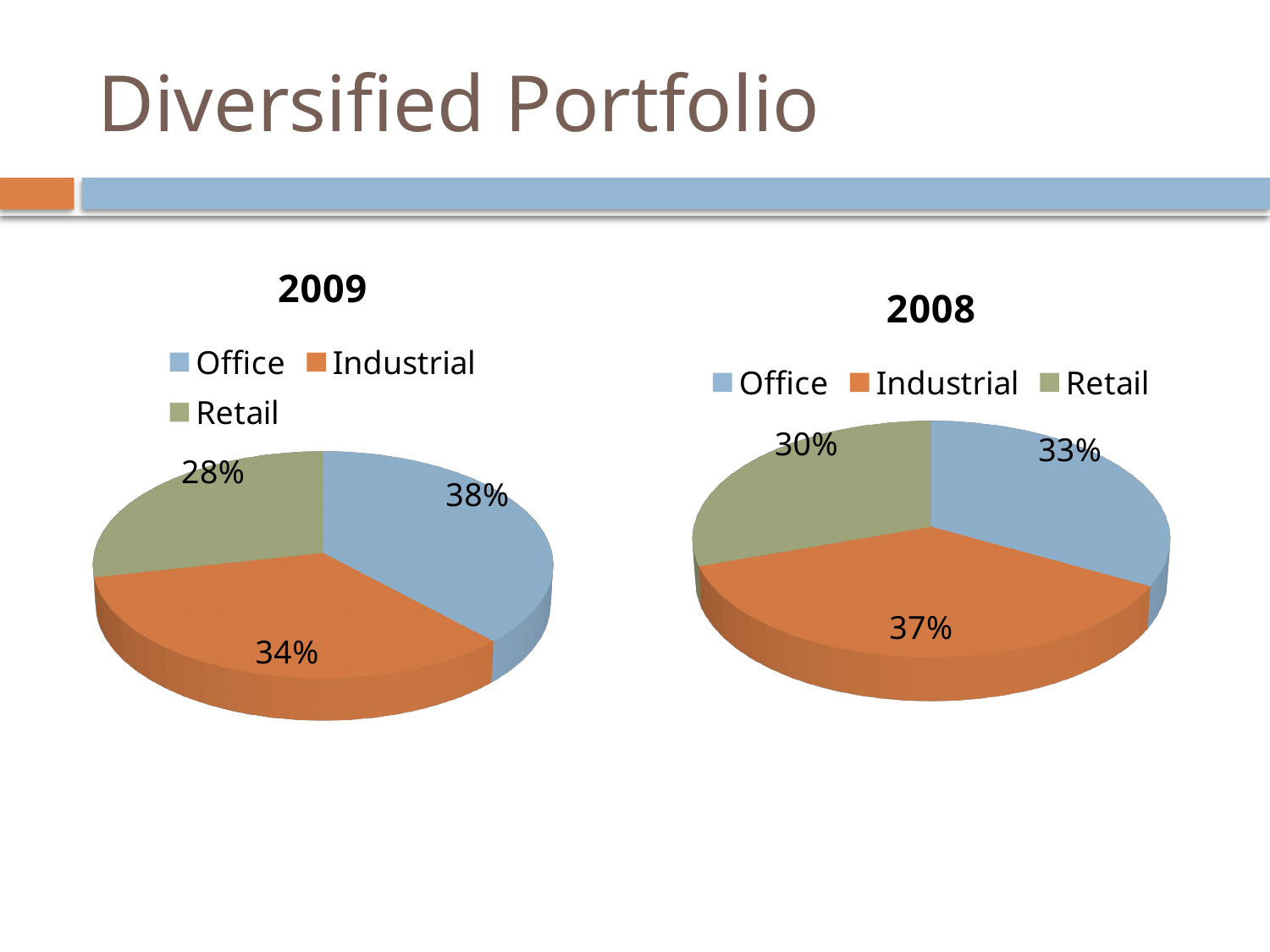
In the 2008 pie chart, which category has the smallest share? Retail In the 2008 pie chart, what share does Industrial have? 37% In the 2009 pie chart, what share does Office have? 38% In the 2009 pie chart, what share does Industrial have? 34% In the 2009 pie chart, which category has the largest share? Office In the 2008 pie chart, what share does Office have? 33% What type of chart is the 2009 chart? Pie chart In the 2008 pie chart, which is larger, Industrial or Office? Industrial In the 2008 pie chart, what share does Retail have? 30% In the 2009 pie chart, what share does Retail have? 28% In the 2009 pie chart, what is the difference between the Office share and the Retail share? 10% How many categories does the 2008 pie chart show? 3